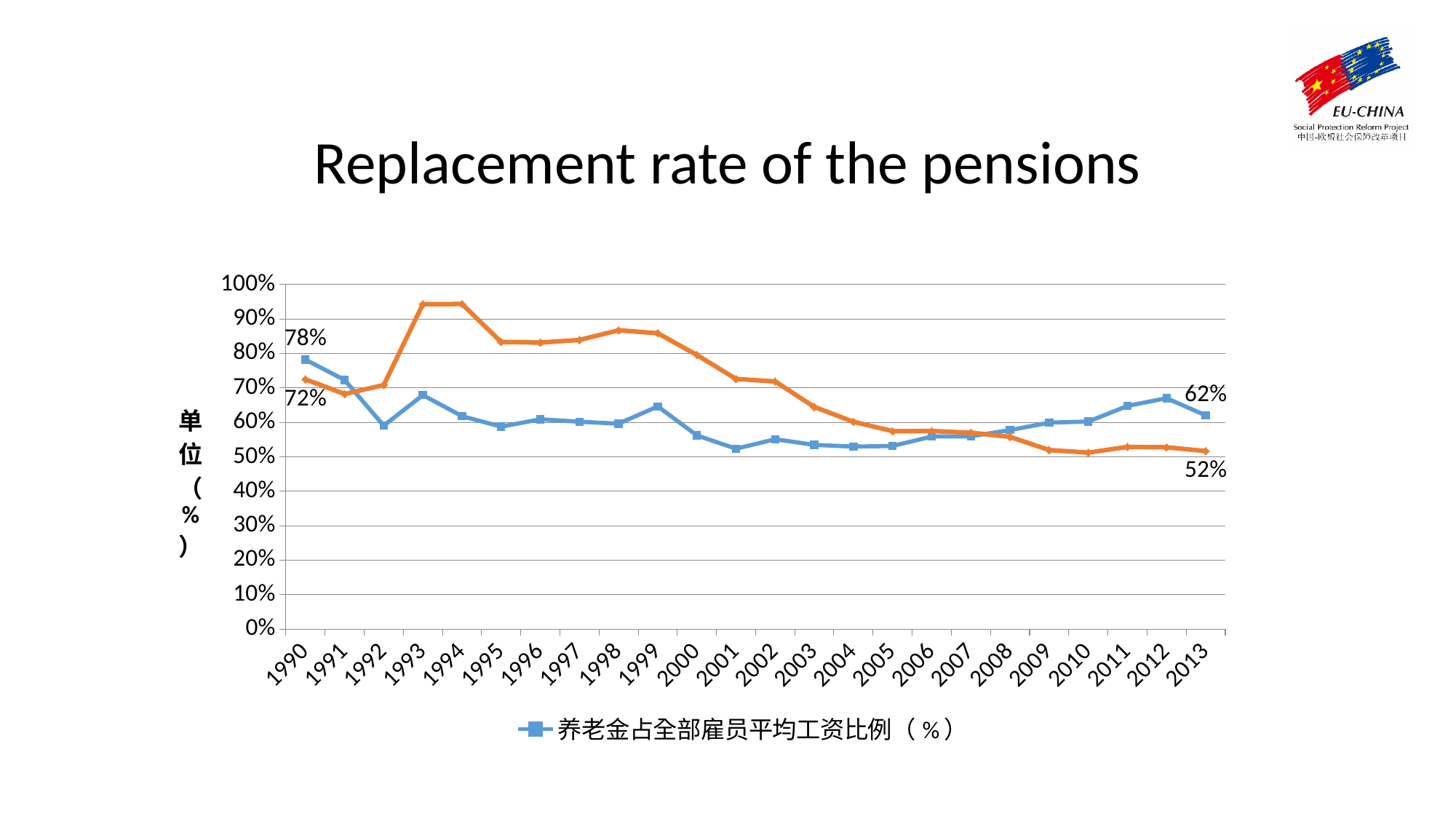
By how many percentage points did the blue series (养老金占全部雇员平均工资比例) fall from 1990 to 2013? 16 percentage points In 2013, which series has the higher value, the blue series or the orange series? the blue series How many series does the legend list? 1 What is the value of the orange series in 1990? 72% What is the value of the orange series in 2013? 52% What is the value of the blue series (养老金占全部雇员平均工资比例) in 1990? 78% What kind of chart is shown on the slide? line chart What is the value of the blue series (养老金占全部雇员平均工资比例) in 2013? 62% How many years are shown on the x axis? 24 What is the title of the chart? Replacement rate of the pensions Is the value of the orange series in 1994 greater or less than 90%? greater By how many percentage points did the orange series fall from 1990 to 2013? 20 percentage points